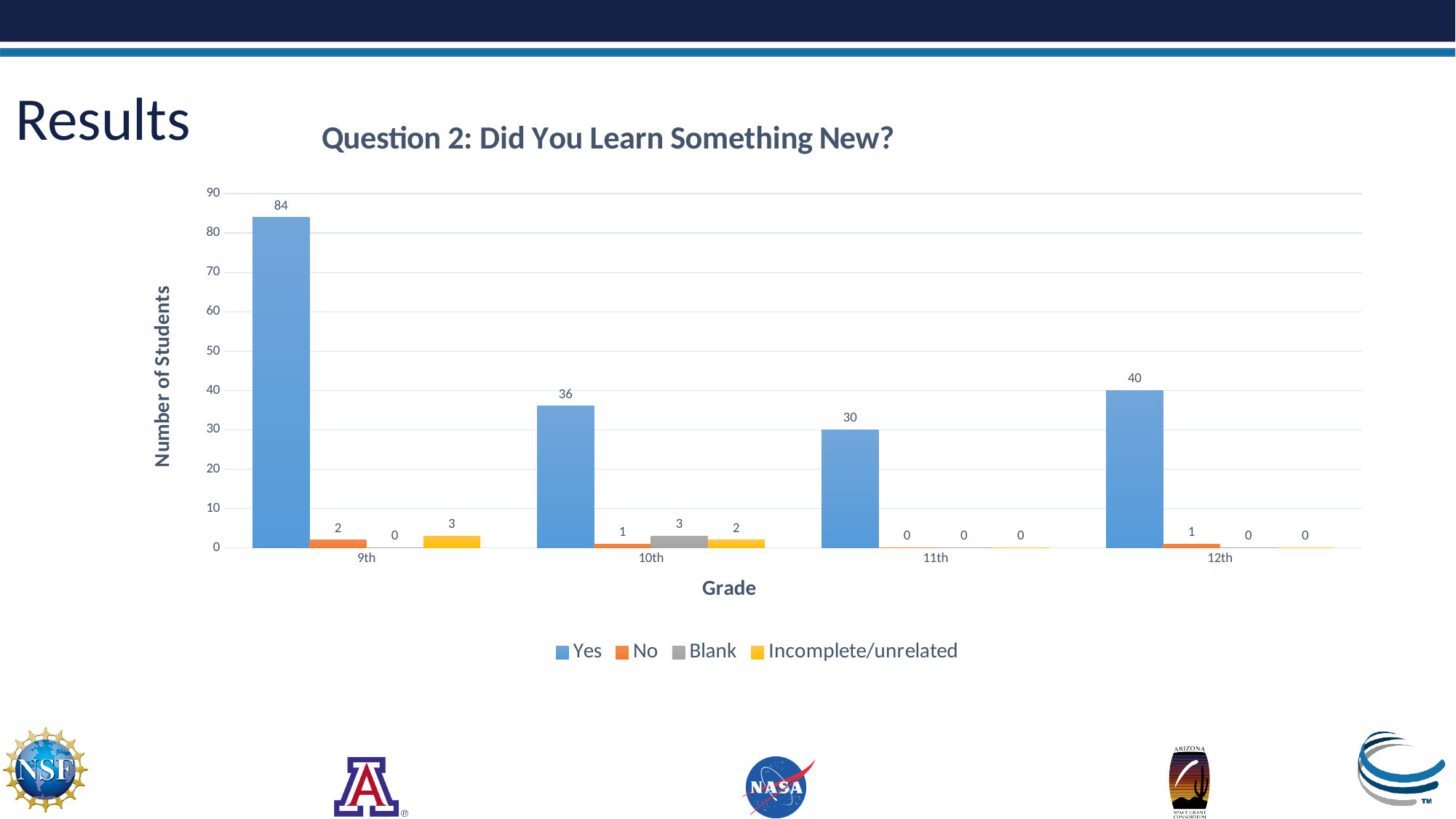
What is the value for Incomplete/unrelated in 9th grade? 3 What is the number of students who answered Yes in 9th grade? 84 Is the Yes value for 11th grade greater or less than 40? less How many series does the legend list? 4 How many 10th grade students left the question Blank? 3 What is the difference between the Yes responses for 9th grade and 12th grade? 44 How many 12th grade students answered No? 1 Which grade has the highest number of Yes responses? 9th What type of chart is shown on the slide? bar chart How many grade categories are shown on the x axis? 4 Which grade has the lowest number of Yes responses? 11th Which is larger, the Yes value for 10th grade or for 12th grade? 12th